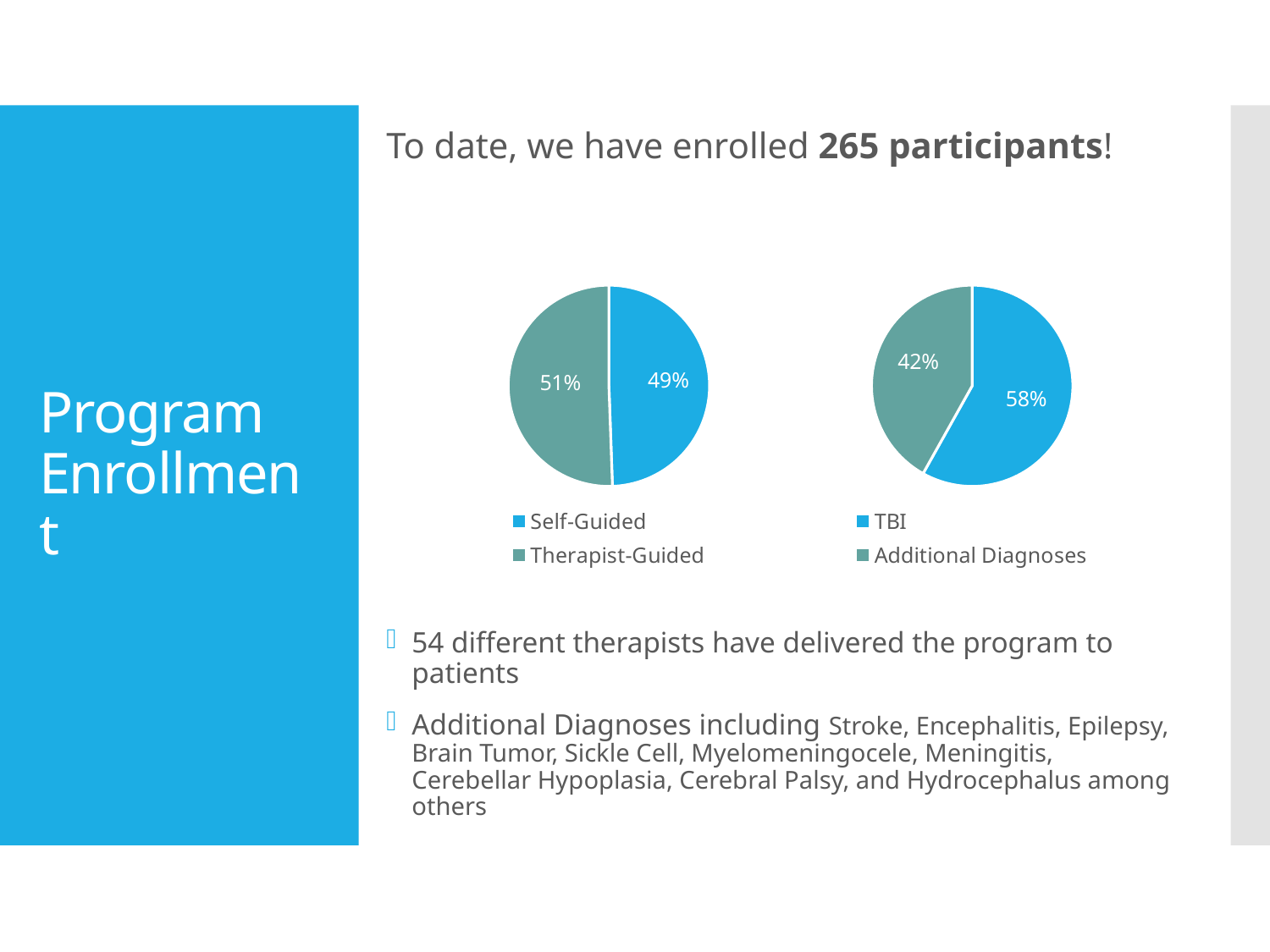
How many entries does the legend of the left pie chart list? 2 How many slices does the right pie chart have? 2 What type of chart is used on the left side of the slide? Pie chart In the right pie chart, what is the difference in percentage points between the TBI slice and the Additional Diagnoses slice? 16 In the left pie chart, what percentage is labelled for Self-Guided? 49% In the right pie chart, what colour is the TBI slice? Blue In the right pie chart, what percentage is labelled for Additional Diagnoses? 42% In the right pie chart, what percentage is labelled for TBI? 58% In the right pie chart, which slice is larger, TBI or Additional Diagnoses? TBI In the left pie chart, which slice is larger according to the printed labels, Self-Guided or Therapist-Guided? Therapist-Guided In the left pie chart, what percentage is labelled for Therapist-Guided? 51% In the left pie chart, what is the difference in percentage points between the Therapist-Guided slice and the Self-Guided slice? 2